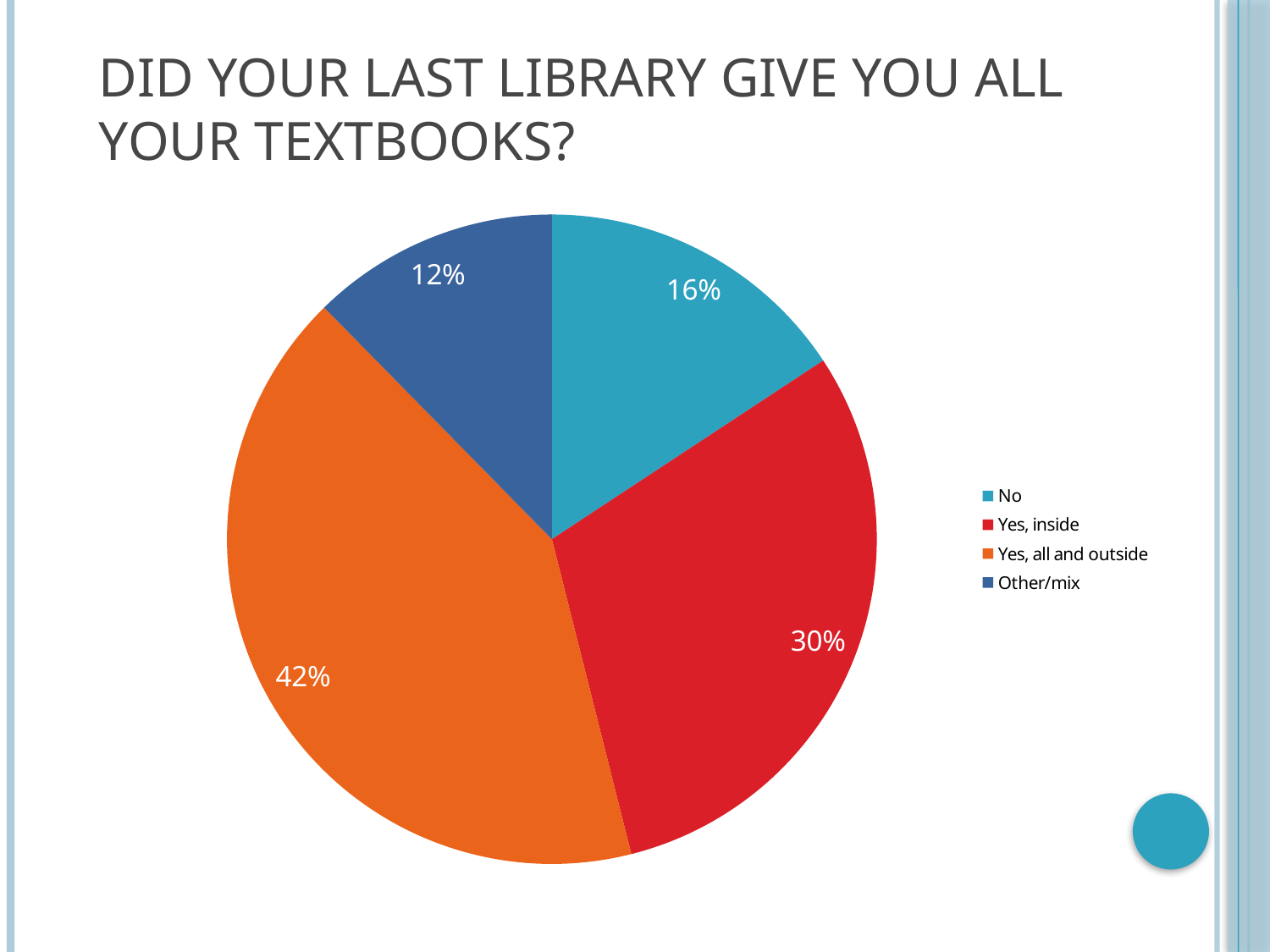
Which category has the largest slice of the pie? Yes, all and outside What share of the pie is labelled "Other/mix"? 12% Which is larger, the share for "No" or the share for "Yes, inside"? Yes, inside What share of the pie is labelled "Yes, inside"? 30% Which category has the smallest slice of the pie? Other/mix What colour is the slice for "Yes, all and outside"? orange What is the difference in percentage points between "Yes, all and outside" and "Yes, inside"? 12 What kind of chart is shown on the slide? pie chart How many categories does the pie chart show? 4 What share of the pie is labelled "Yes, all and outside"? 42% What is the title of the chart on the slide? Did your last library give you all your textbooks?